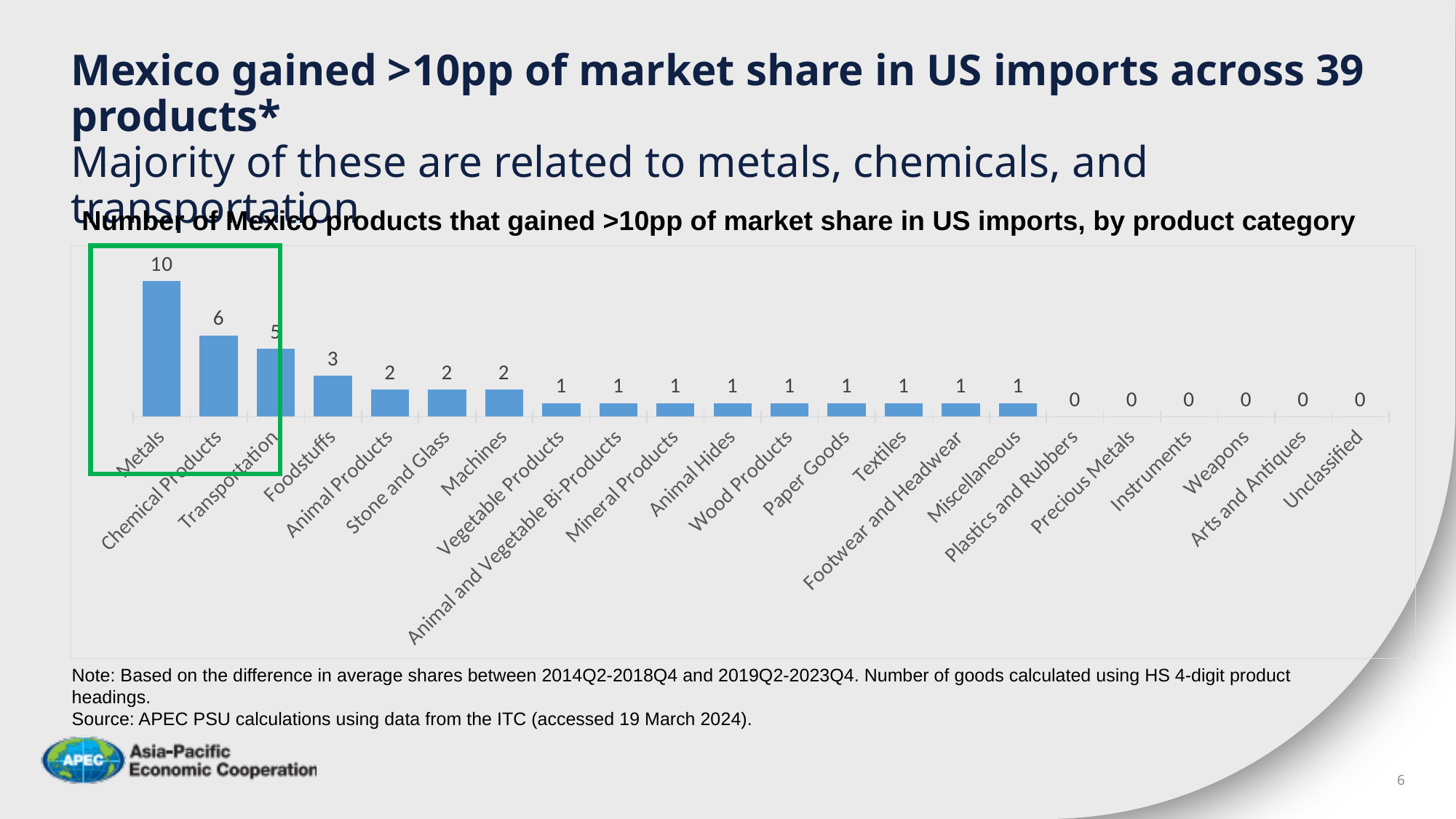
What kind of chart is shown on the slide? Bar chart What is the value for Foodstuffs? 3 What is the value for Transportation? 5 Which product category has the highest value? Metals Do the values rise or fall moving from left to right along the x axis? Fall What is the value for Metals? 10 What is the title of the chart? Number of Mexico products that gained >10pp of market share in US imports, by product category What is the value for Chemical Products? 6 What is the difference between the values for Metals and Chemical Products? 4 What is the value for Plastics and Rubbers? 0 Which is larger, the value for Transportation or the value for Foodstuffs? Transportation How many product categories are shown on the x axis? 22